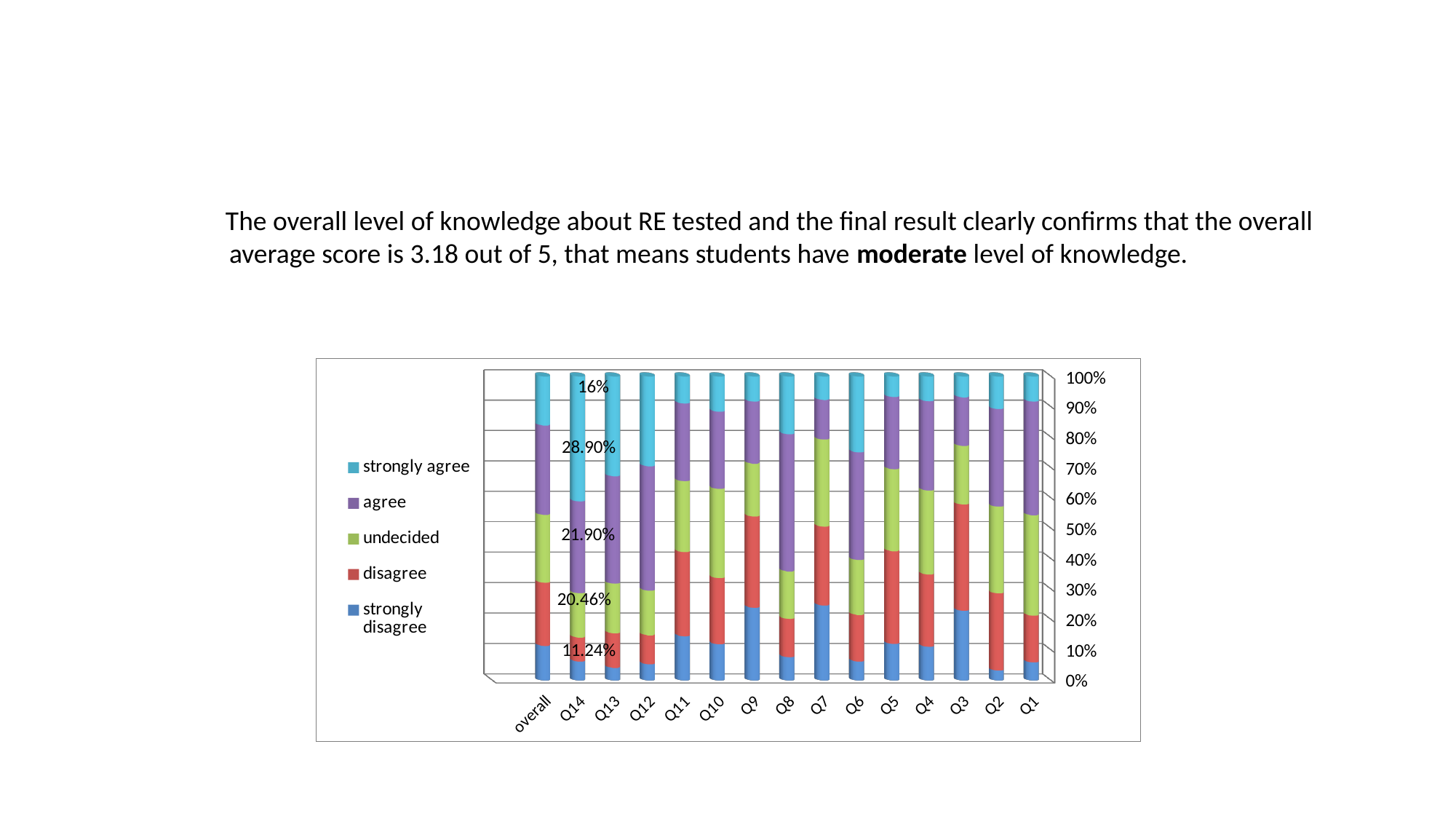
What kind of chart is shown on the slide? stacked bar chart How many series does the legend list? 5 What is the 'undecided' value labelled for the 'overall' bar? 21.90% Which series is shown at the top of each stacked bar, according to the legend? strongly agree Is the 'strongly agree' share for Q14 greater or less than 30%? greater Which question bar has the largest 'strongly agree' share? Q14 What is the 'agree' value labelled for the 'overall' bar? 28.90% What is the 'strongly agree' value labelled for the 'overall' bar? 16% Which has a larger 'strongly agree' share, Q14 or Q7? Q14 Is the 'strongly disagree' share for Q2 greater or less than 10%? less How many categories are shown along the x axis? 15 What is the 'strongly disagree' value labelled for the 'overall' bar? 11.24%